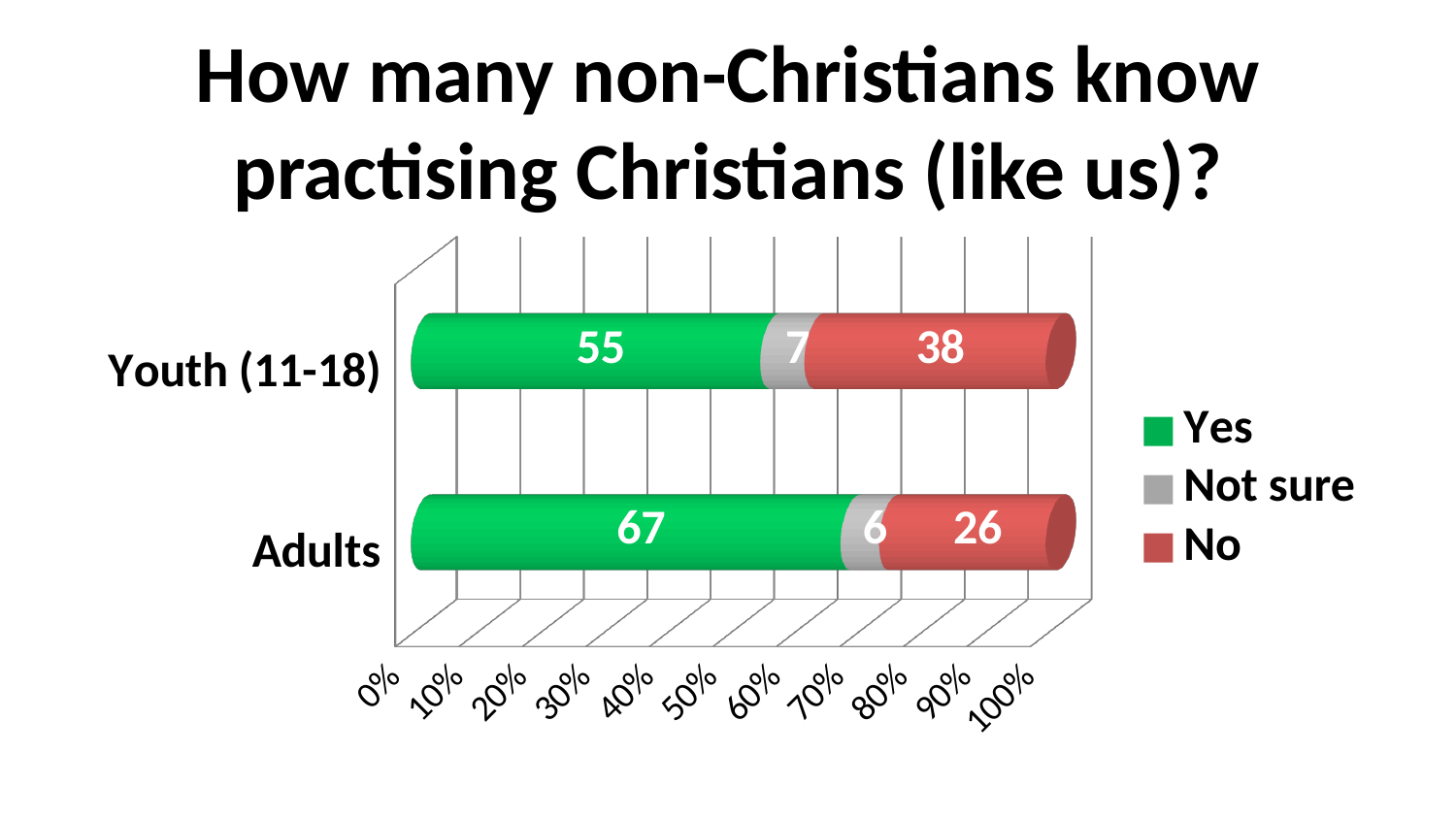
Which group has the higher 'Yes' value, Youth (11-18) or Adults? Adults What is the difference between the 'No' values for Youth (11-18) and Adults? 12 How many categories are shown on the chart? 2 What is the difference between the 'Yes' values for Adults and Youth (11-18)? 12 What kind of chart is shown on the slide? Stacked bar chart What is the 'Yes' value for Youth (11-18)? 55 What is the 'Not sure' value for Youth (11-18)? 7 What is the total of the stacked bar for Adults? 99 What is the 'Yes' value for Adults? 67 What is the 'No' value for Adults? 26 How many series does the legend list? 3 Which group has the higher 'No' value, Youth (11-18) or Adults? Youth (11-18)